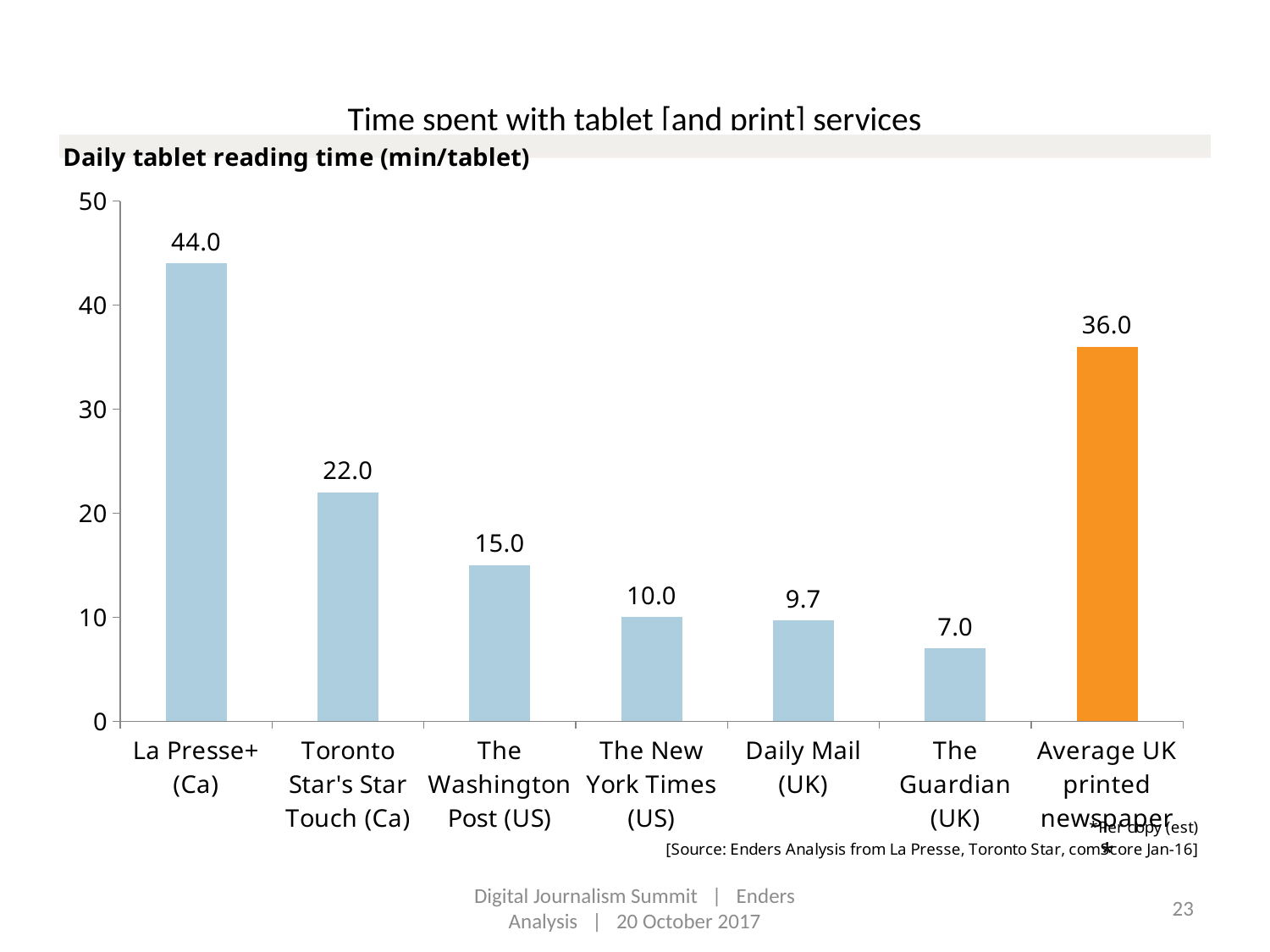
What kind of chart is shown on the slide? Bar chart What is the value shown for The Guardian (UK)? 7.0 Which category has the lowest value on the chart? The Guardian (UK) What is the daily tablet reading time for La Presse+ (Ca)? 44.0 Which is larger, the value for The Washington Post (US) or The New York Times (US)? The Washington Post (US) What is the value shown for Daily Mail (UK)? 9.7 What is the value shown for Average UK printed newspaper? 36.0 Which category has the highest daily tablet reading time? La Presse+ (Ca) What is the difference between the values for La Presse+ (Ca) and Toronto Star's Star Touch (Ca)? 22.0 How many categories are shown on the chart? 7 Which bar is coloured orange rather than blue? Average UK printed newspaper Do the values for the six newspaper tablet services rise or fall from left to right? Fall